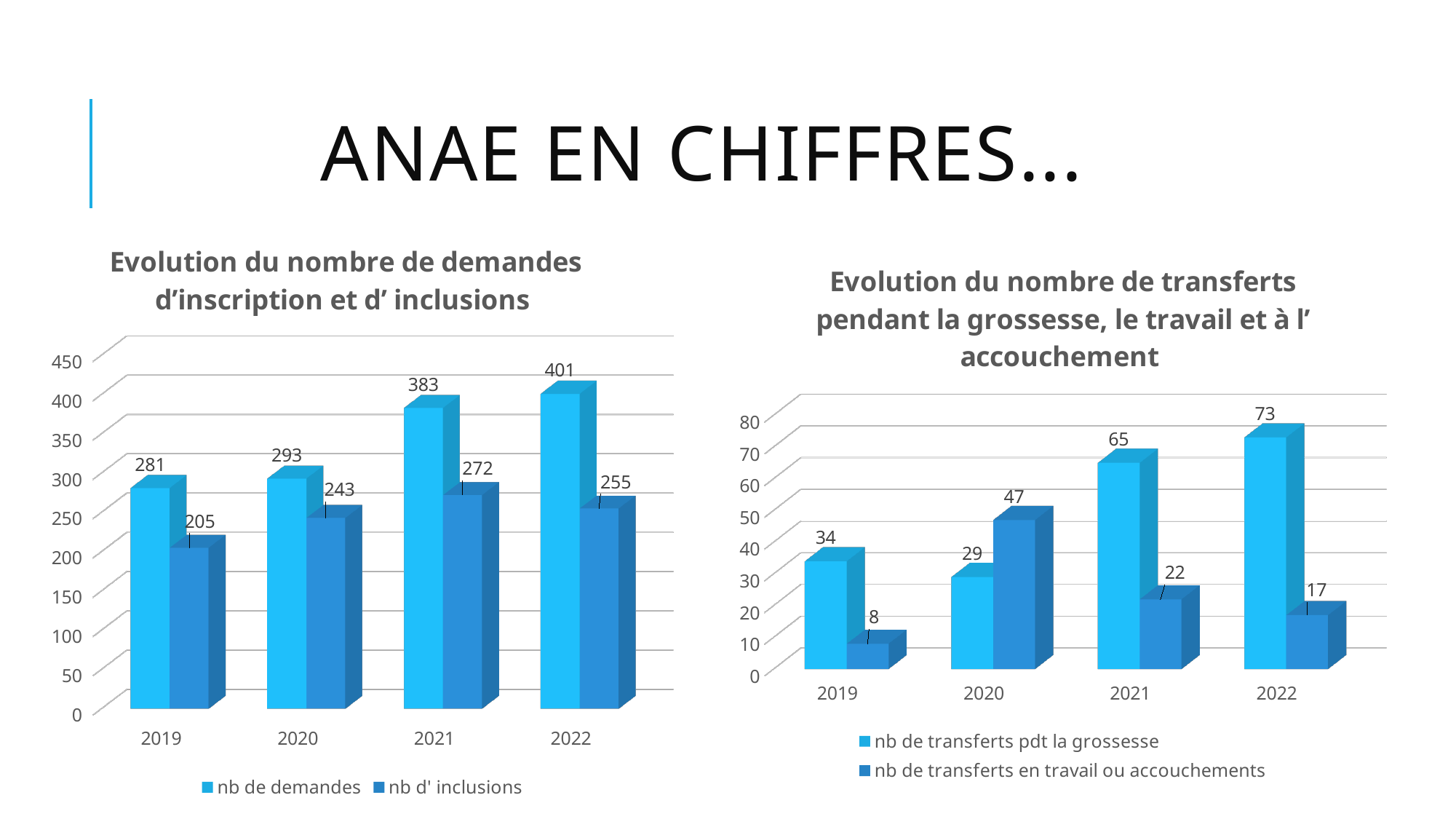
In the left chart, which year has the highest nb de demandes? 2022 In the left chart (Evolution du nombre de demandes d'inscription et d' inclusions), what is the value of nb de demandes for 2021? 383 In the right chart (Evolution du nombre de transferts), what is the value of nb de transferts pdt la grossesse for 2021? 65 How many series does the legend of the right chart list? 2 In the left chart, which year has the lowest nb d' inclusions? 2019 What kind of chart is the left chart? bar chart In the left chart, what is the value of nb d' inclusions for 2020? 243 In the right chart, which is larger in 2020: nb de transferts pdt la grossesse or nb de transferts en travail ou accouchements? nb de transferts en travail ou accouchements In the right chart, what is the value of nb de transferts en travail ou accouchements for 2019? 8 In the left chart, what is the difference between nb de demandes and nb d' inclusions in 2022? 146 In the right chart, which year has the highest nb de transferts en travail ou accouchements? 2020 In the left chart, does nb de demandes rise or fall from 2019 to 2022? rise